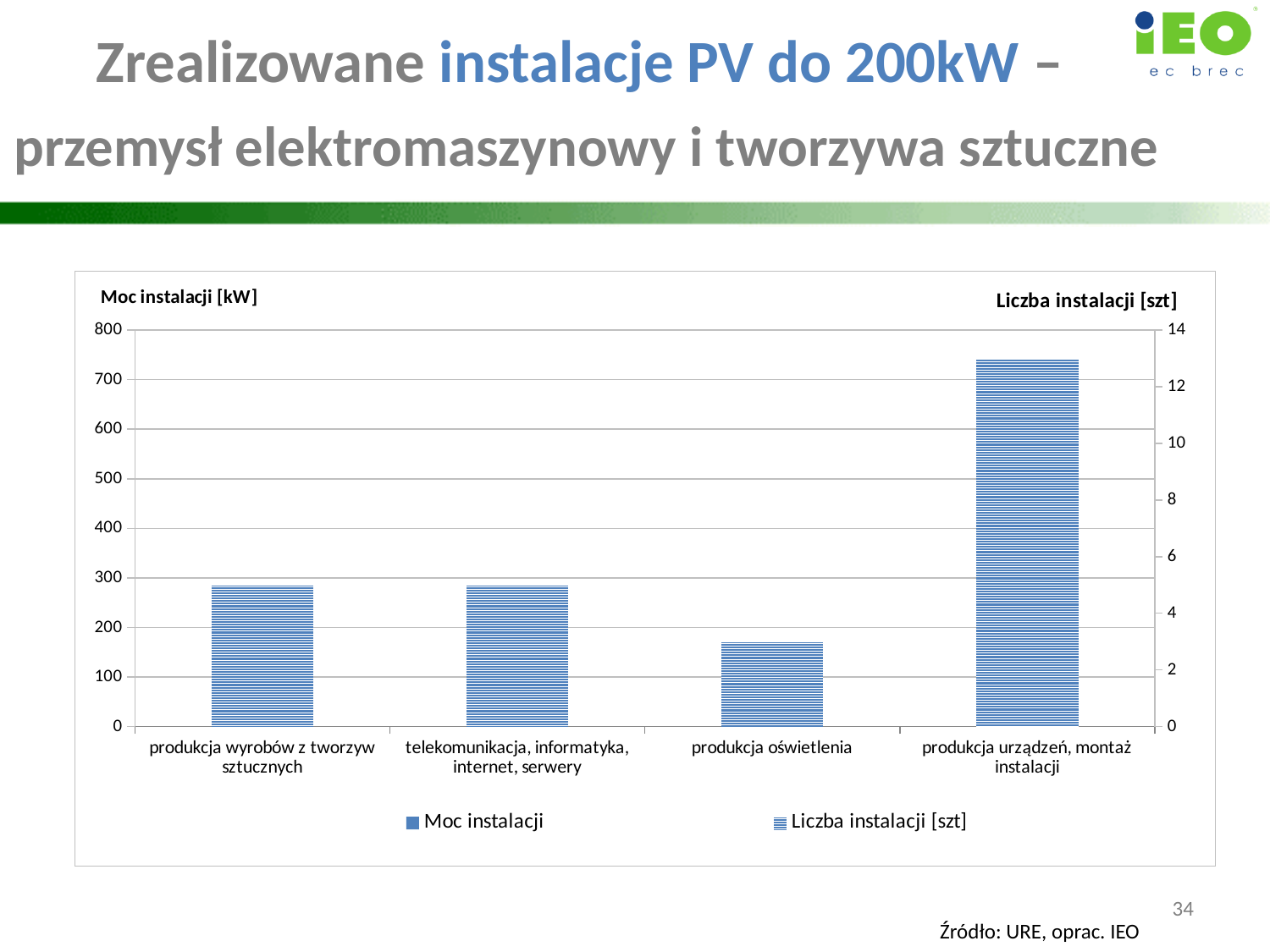
What is the title of the left-hand vertical axis of the chart? Moc instalacji [kW] On the right-hand axis (Liczba instalacji [szt]), is the value for telekomunikacja, informatyka, internet, serwery greater or less than 4? greater What is the title of the right-hand vertical axis of the chart? Liczba instalacji [szt] On the right-hand axis (Liczba instalacji [szt]), is the value for produkcja urządzeń, montaż instalacji greater or less than 12? greater On the right-hand axis (Liczba instalacji [szt]), is the value for produkcja oświetlenia greater or less than 4? less Which bar is taller: produkcja oświetlenia or produkcja urządzeń, montaż instalacji? produkcja urządzeń, montaż instalacji Which category has the tallest bar in the chart? produkcja urządzeń, montaż instalacji How many categories are shown on the x axis of the chart? 4 Which category has the shortest bar in the chart? produkcja oświetlenia What kind of chart is shown on the slide? bar chart How many series does the chart legend list? 2